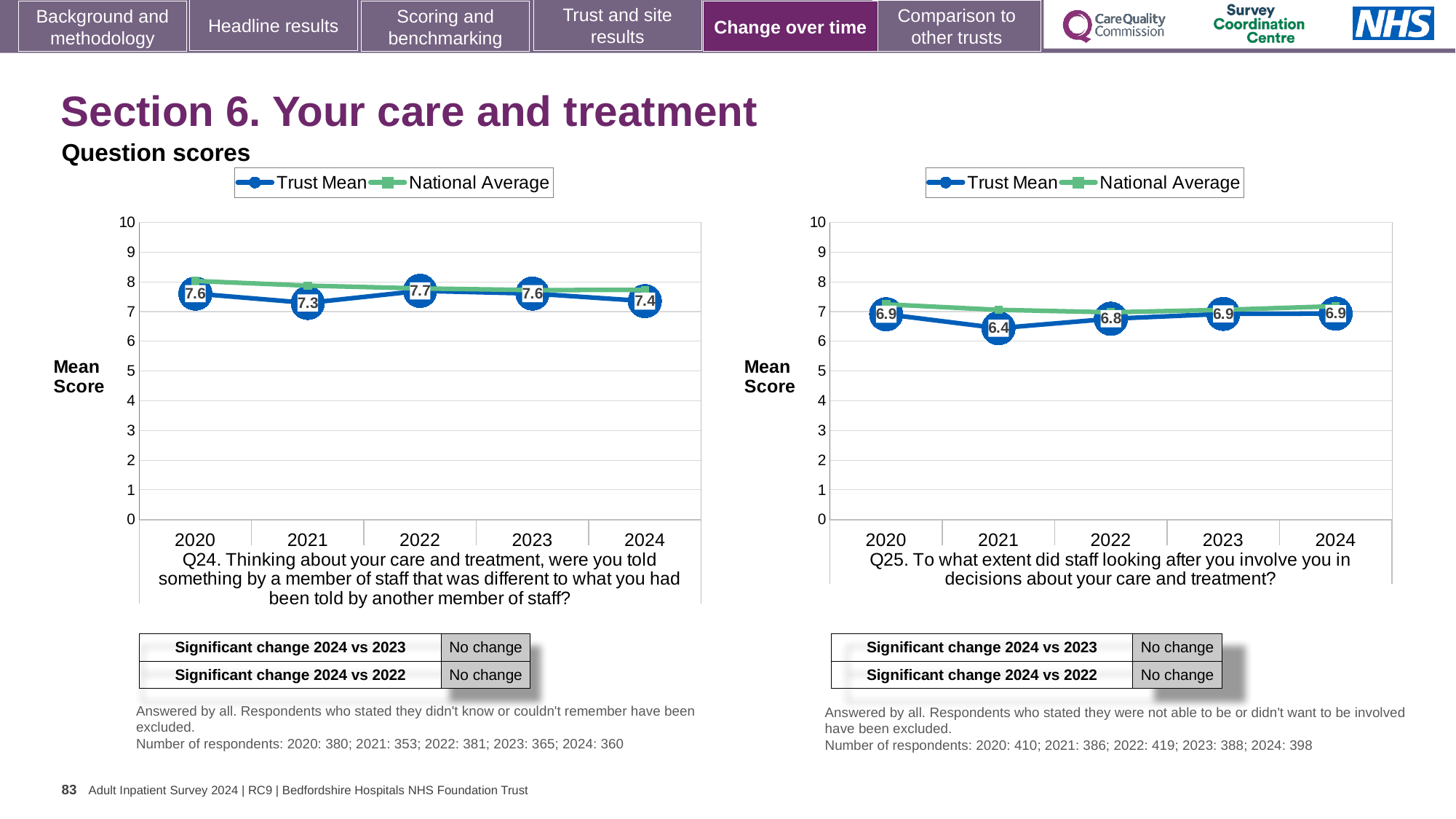
On the Q25 chart (right), is the National Average for 2021 greater or less than 8? less On the Q25 chart (right), what is the Trust Mean score for 2021? 6.4 On the Q25 chart (right), what is the Trust Mean score for 2022? 6.8 On the Q25 chart (right), which year has the lowest Trust Mean score? 2021 How many series does the legend of the Q25 chart (right) list? 2 How many years are plotted on the Q24 chart (left)? 5 On the Q24 chart (left), which year has the lowest Trust Mean score? 2021 On the Q24 chart (left), what is the Trust Mean score for 2021? 7.3 On the Q25 chart (right), is the Trust Mean score for 2020 or 2021 larger? 2020 On the Q24 chart (left), what is the Trust Mean score for 2024? 7.4 On the Q24 chart (left), what is the difference between the Trust Mean scores for 2022 and 2021? 0.4 On the Q24 chart (left), which year has the highest Trust Mean score? 2022